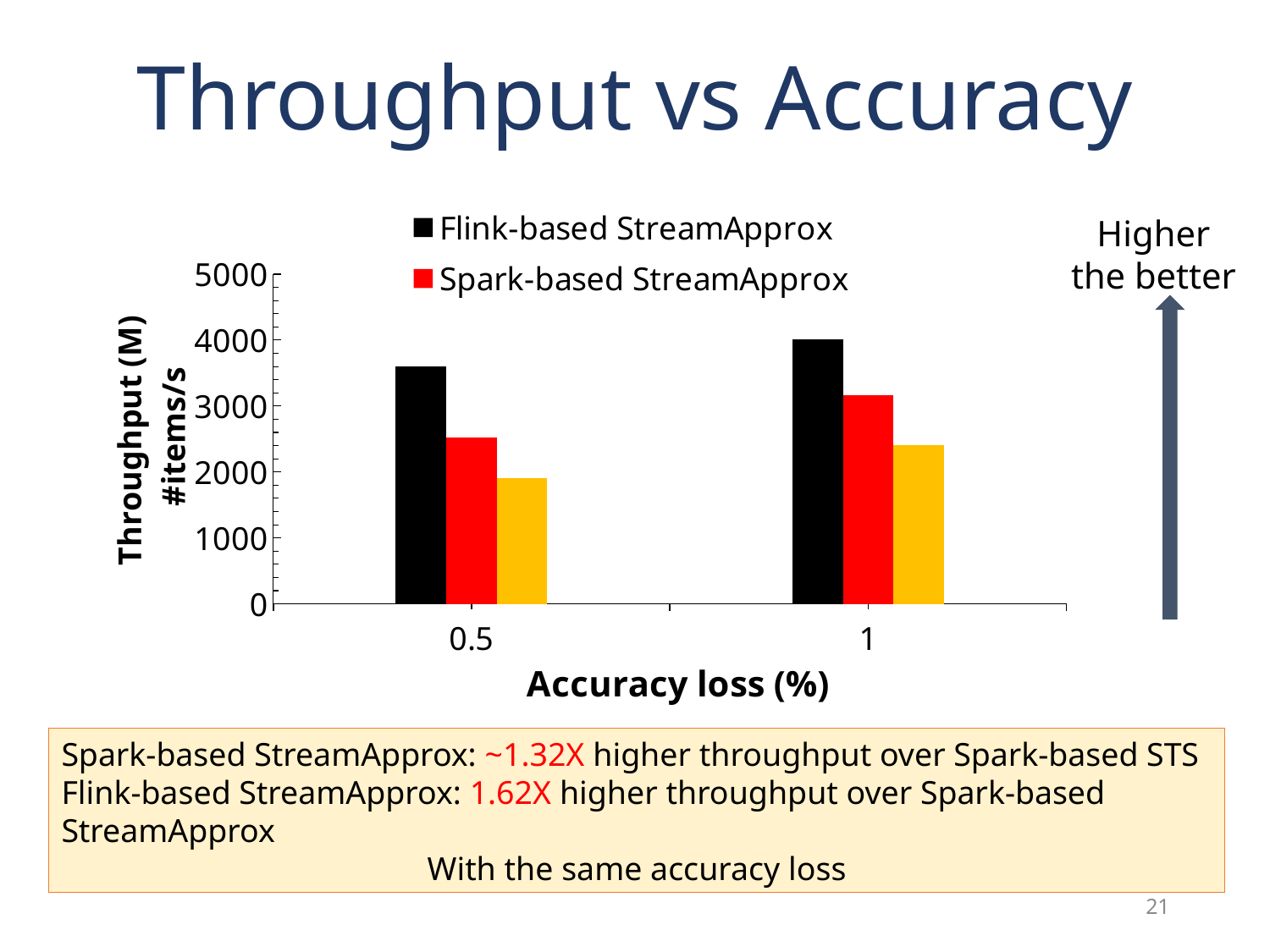
Is the throughput of Spark-based StreamApprox at 0.5% accuracy loss greater or less than 3000? less Which bar in the chart is the tallest overall? Flink-based StreamApprox at 1% accuracy loss Which series has the higher throughput at 1% accuracy loss, Flink-based StreamApprox or Spark-based StreamApprox? Flink-based StreamApprox How many series does the chart's legend list? 2 Does the throughput of Flink-based StreamApprox rise or fall as accuracy loss increases from 0.5% to 1%? rise Is the throughput of Spark-based StreamApprox at 1% accuracy loss greater or less than 3000? greater What is the label of the y axis? Throughput (M) #items/s Is the throughput of Flink-based StreamApprox at 0.5% accuracy loss greater or less than 3000? greater How many accuracy-loss categories are shown on the x axis? 2 What kind of chart is shown on the slide? bar chart What colour represents Spark-based StreamApprox in the legend? red